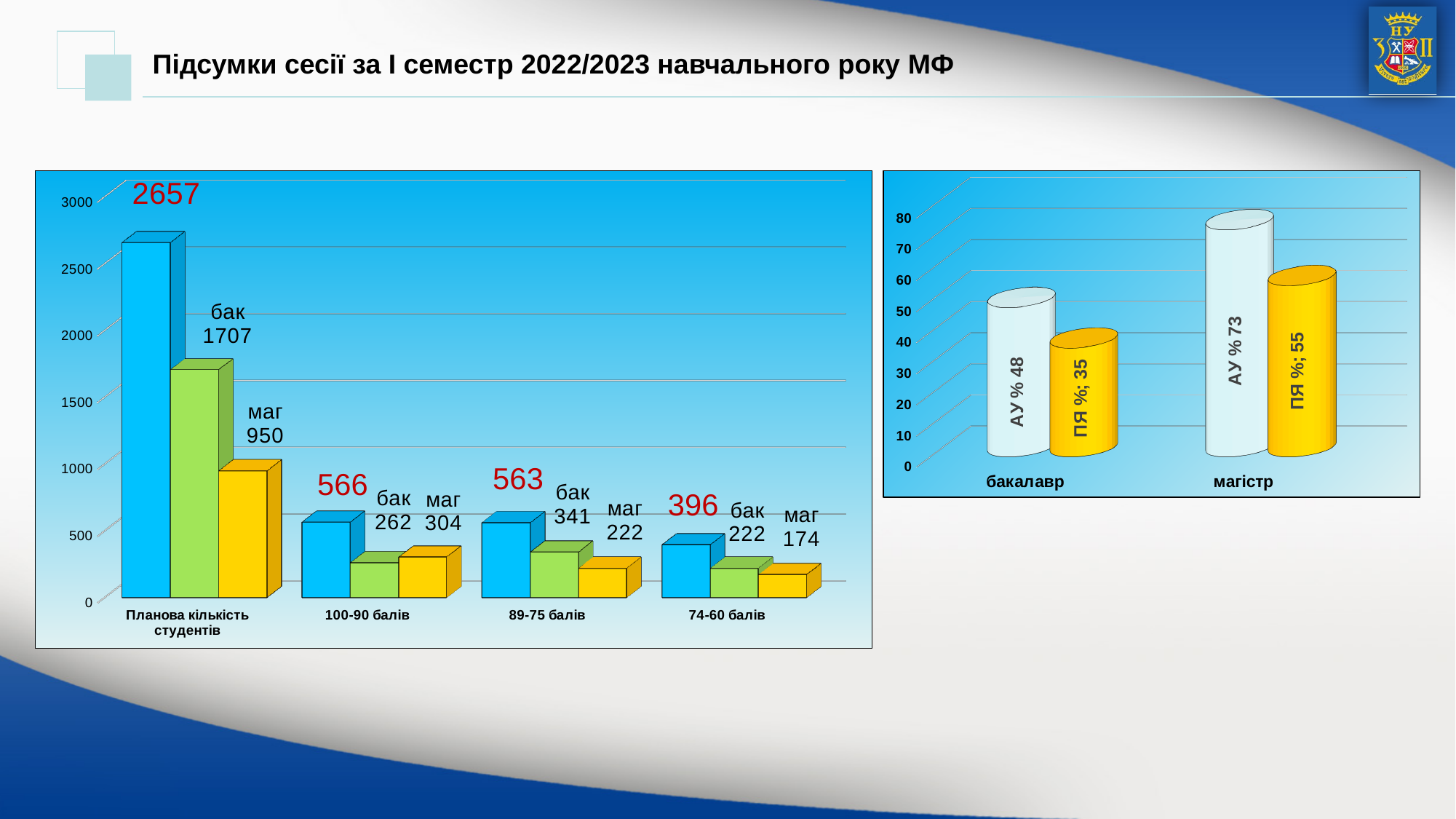
In the left chart, what is the 'маг' value for the '74-60 балів' category? 174 In the right chart, what is the difference between the 'АУ %' values for 'магістр' and 'бакалавр'? 25 In the left chart, what is the 'маг' value for the '100-90 балів' category? 304 In the left chart, what is the value printed above the blue bar for 'Планова кількість студентів'? 2657 In the right chart, what is the 'ПЯ %' value for 'бакалавр'? 35 How many categories are shown on the x axis of the left chart? 4 In the left chart, what is the 'бак' value for the '89-75 балів' category? 341 In the left chart, what is the difference between the 'бак' and 'маг' values for 'Планова кількість студентів'? 757 In the left chart, is the 'бак' value for '100-90 балів' or the 'маг' value for '100-90 балів' larger? маг (304) In the left chart, which category has the lowest red total value? 74-60 балів What type of chart is the left chart? Bar chart In the right chart, what is the 'АУ %' value for 'магістр'? 73